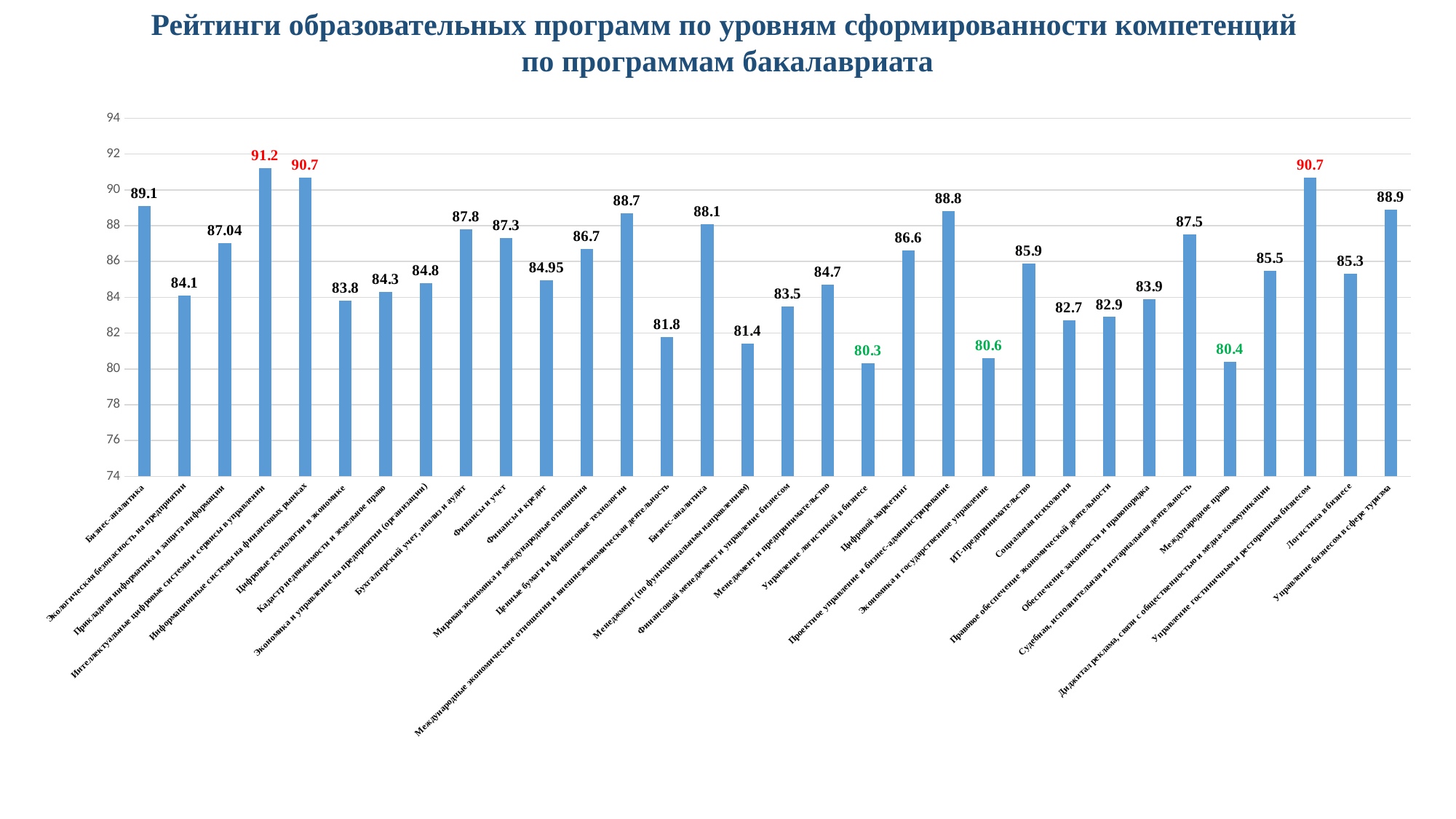
In what colour are the data labels of the three highest bars printed? red What kind of chart is shown on the slide? bar chart Is the value for Международное право greater or less than 82? less Which programme has the lowest rating? Управление логистикой в бизнесе Which is larger: the value for Логистика в бизнесе or the value for Социальная психология? Логистика в бизнесе What value is shown for Цифровой маркетинг? 86.6 What value is shown for Интеллектуальные цифровые системы в управлении? 91.2 What is the difference between the highest rating (91.2) and the lowest rating (80.3)? 10.9 Which programme has the highest rating? Интеллектуальные цифровые системы и сервисы в управлении What value is shown for Финансы и кредит? 84.95 What value is shown for Прикладная информатика и защита информации? 87.04 How many programmes (bars) are shown in the chart? 32